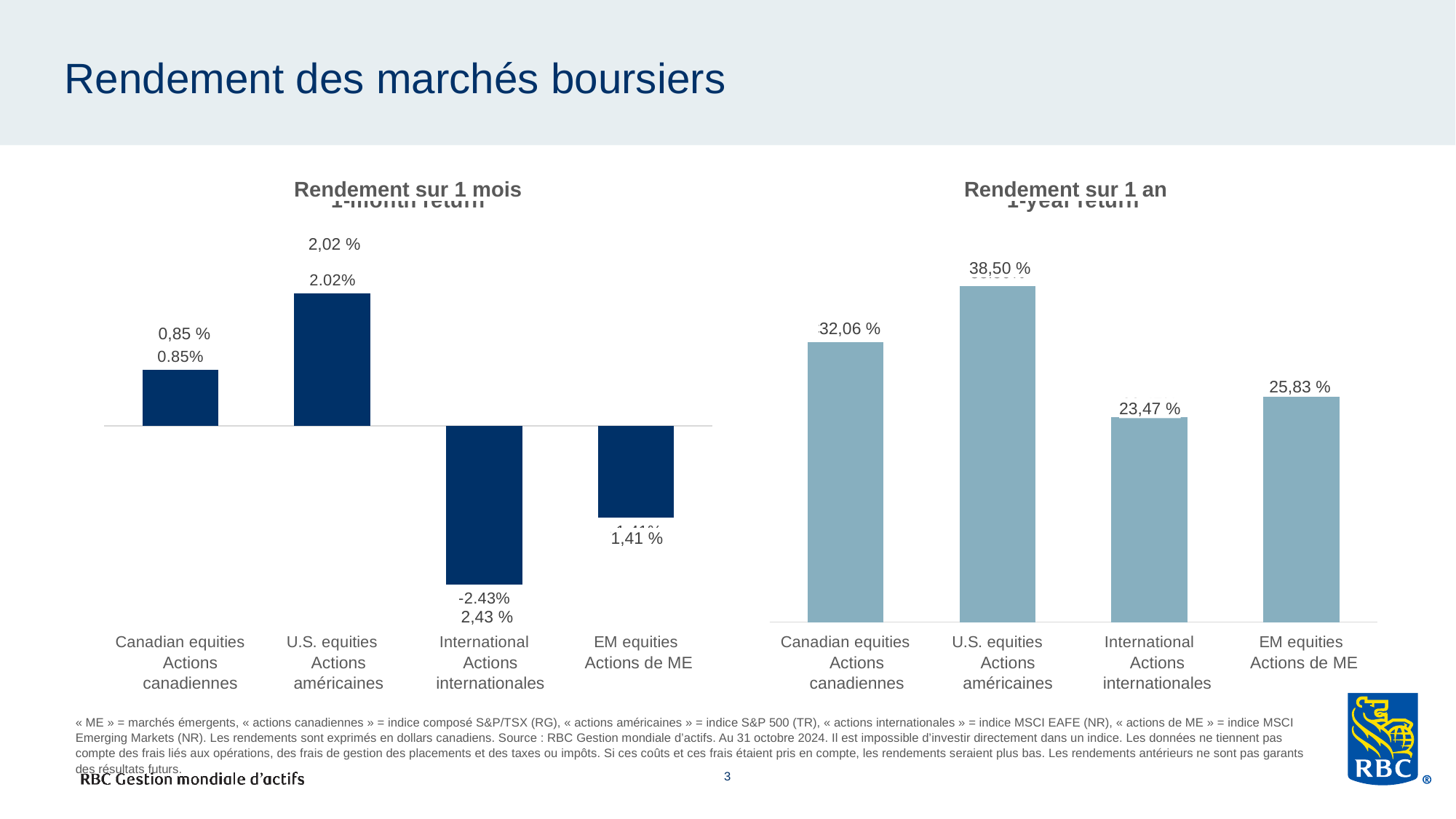
In the 'Rendement sur 1 mois' chart, which category has the highest value? U.S. equities (Actions américaines) In the 'Rendement sur 1 mois' chart, which category has the lowest value? International equities (Actions internationales) In the 'Rendement sur 1 an' chart, which category has the lowest value? International equities (Actions internationales) How many categories are shown in the 'Rendement sur 1 an' chart? 4 In the 'Rendement sur 1 an' chart, which category has the highest value? U.S. equities (Actions américaines) In the 'Rendement sur 1 mois' chart, which is larger: the value for Canadian equities or the value for EM equities? Canadian equities In the 'Rendement sur 1 an' chart, what is the difference between EM equities and International equities? 2,36 % What kind of chart is the 'Rendement sur 1 mois' chart? bar chart In the 'Rendement sur 1 an' chart, what is the difference between U.S. equities and Canadian equities? 6,44 % In the 'Rendement sur 1 an' chart, what is the value for Canadian equities (Actions canadiennes)? 32,06 % In the 'Rendement sur 1 an' chart, what is the value for U.S. equities (Actions américaines)? 38,50 % In the 'Rendement sur 1 mois' chart, what is the value for Canadian equities (Actions canadiennes)? 0,85 %